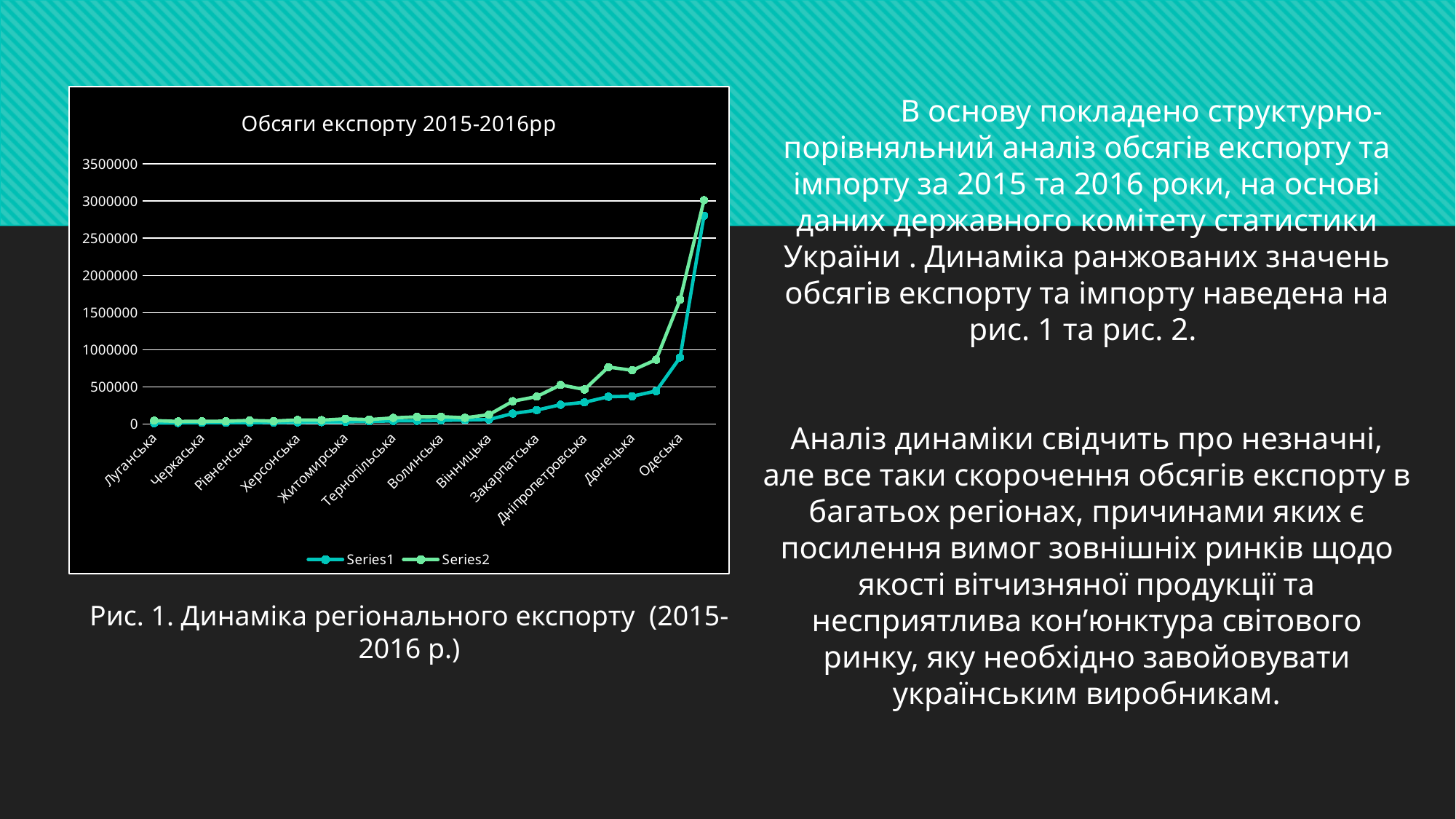
What kind of chart is shown on the slide? line chart Do the values generally rise or fall moving from left to right along the x axis? rise What are the names of the series in the legend? Series1 and Series2 What is the title of the chart? Обсяги експорту 2015-2016рр Is the Series2 value for Закарпатська greater or less than 500000? less How many series does the chart legend list? 2 Is the Series2 value for Одеська greater or less than 2500000? less Is the Series1 value for Донецька greater or less than 500000? less